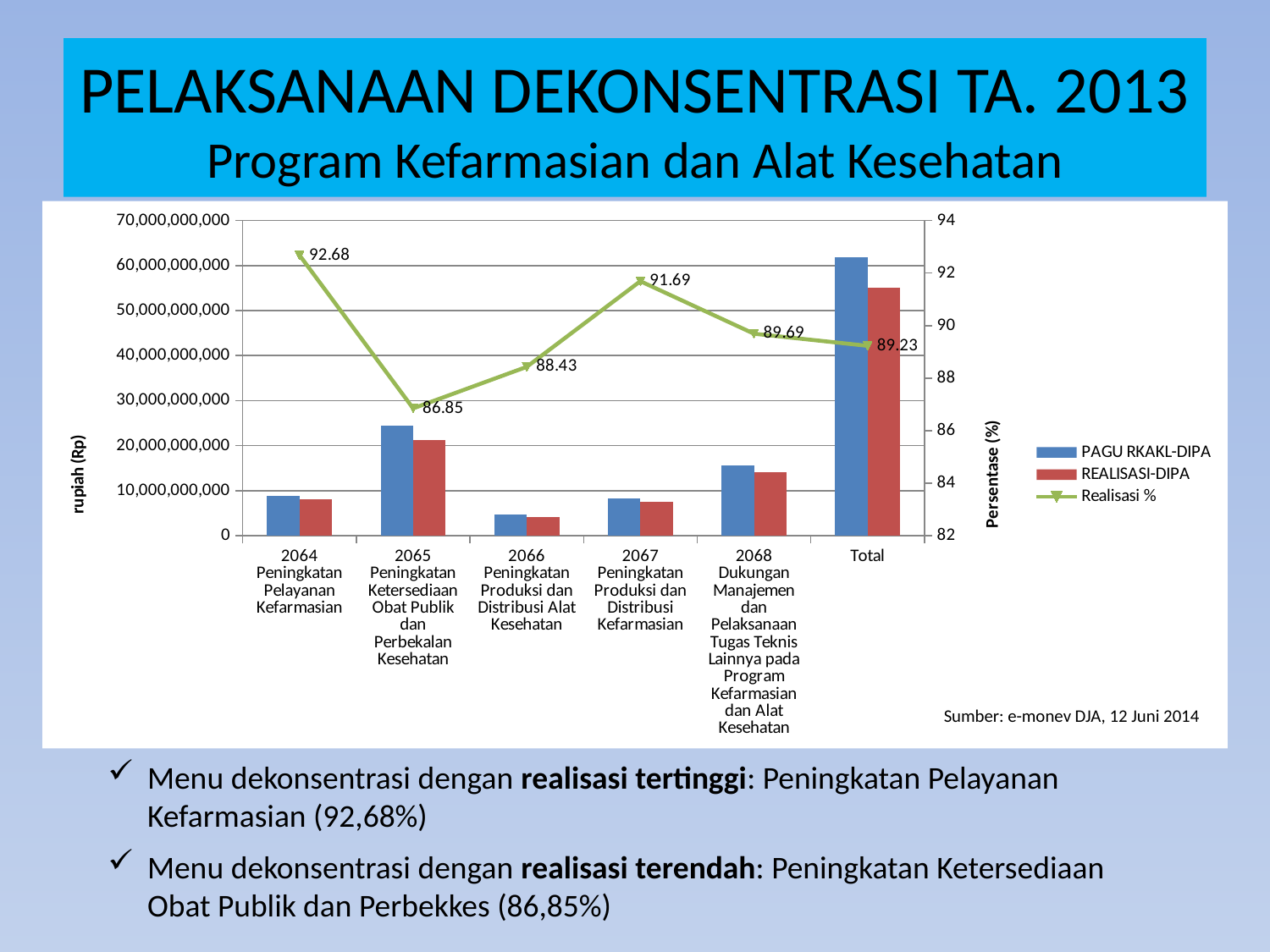
Which category has the highest Realisasi % value? 2064 Peningkatan Pelayanan Kefarmasian Is the PAGU RKAKL-DIPA value for 2066 greater or less than 10,000,000,000? less Which category has the tallest PAGU RKAKL-DIPA bar? Total What is the Realisasi % value for 2067 Peningkatan Produksi dan Distribusi Kefarmasian? 91.69 How many categories are shown on the x axis? 6 Is the PAGU RKAKL-DIPA value for Total greater or less than 60,000,000,000? greater What is the difference between the Realisasi % values for 2064 and 2065? 5.83 Which category has the lowest Realisasi % value? 2065 Peningkatan Ketersediaan Obat Publik dan Perbekalan Kesehatan What is the Realisasi % value for 2064 Peningkatan Pelayanan Kefarmasian? 92.68 How many series does the legend list? 3 For 2065, which is larger: the PAGU RKAKL-DIPA bar or the REALISASI-DIPA bar? PAGU RKAKL-DIPA What is the Realisasi % value for the Total category? 89.23